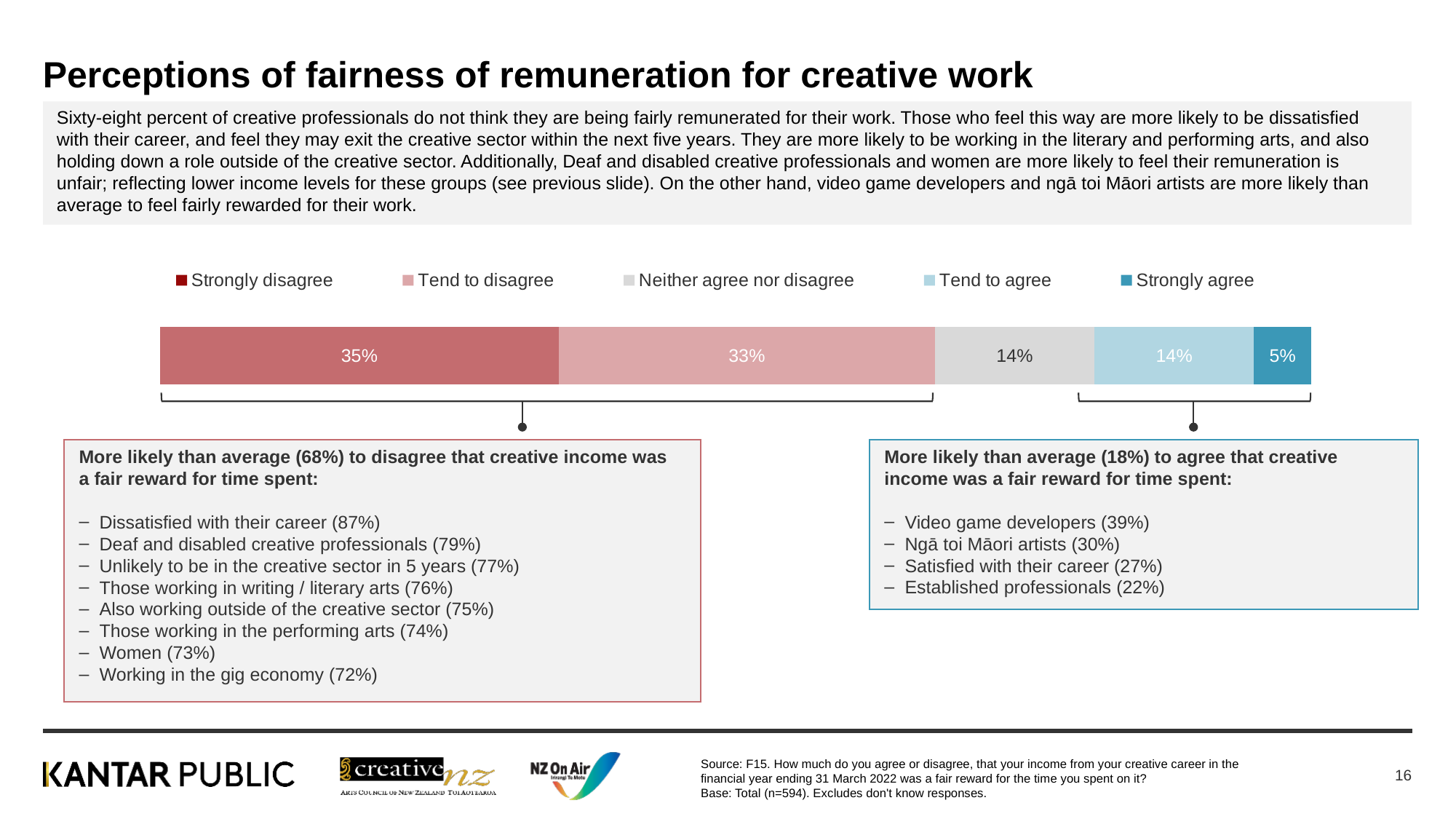
How many response categories does the legend list? 5 Which is larger, the Tend to disagree share or the Tend to agree share? Tend to disagree What type of chart is shown on the slide? Stacked bar chart What is the combined percentage of Strongly disagree and Tend to disagree? 68% Which response category has the smallest share of respondents? Strongly agree What percentage of respondents neither agree nor disagree? 14% Which response category has the largest share of respondents? Strongly disagree What percentage of respondents strongly agree? 5% What percentage of respondents tend to disagree? 33% What is the combined percentage of Tend to agree and Strongly agree? 19% What is the difference between the Strongly disagree and Strongly agree percentages? 30 percentage points What percentage of respondents strongly disagree that their creative income was a fair reward? 35%